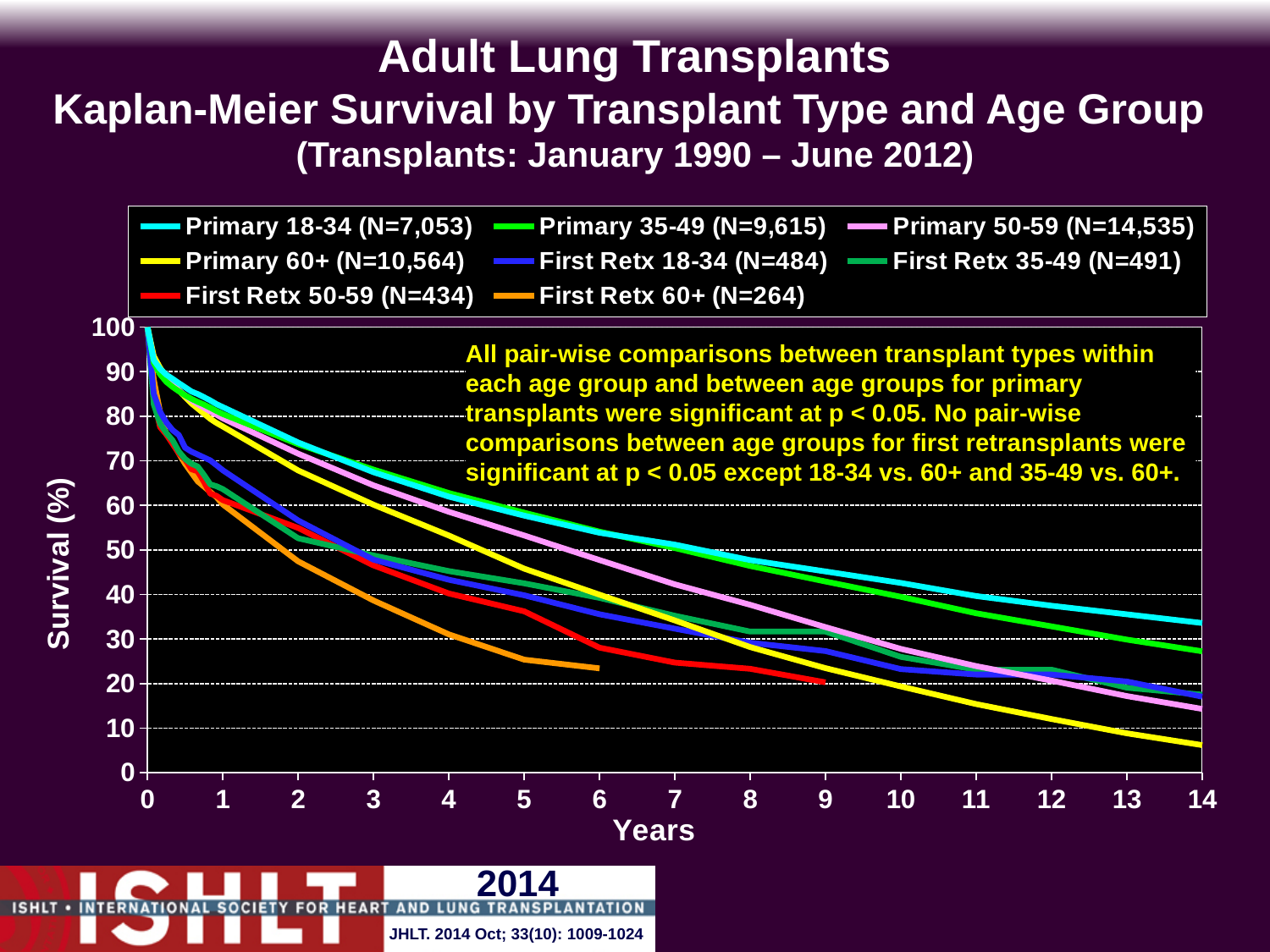
What is the label of the y axis? Survival (%) Is the survival for Primary 60+ at year 14 greater or less than 10? less Which series has the highest survival at year 14? Primary 18-34 (N=7,053) What kind of chart is shown on the slide? line chart According to the legend, what is the N for the Primary 50-59 series? 14,535 Is the survival for Primary 18-34 at year 5 greater or less than 50? greater Is the survival for Primary 18-34 at year 14 greater or less than 30? greater Which series has the lowest survival at year 14? Primary 60+ (N=10,564) At year 14, which has higher survival: Primary 50-59 or Primary 60+? Primary 50-59 How many series does the legend list? 8 Do the survival curves rise or fall as the years increase along the x axis? fall